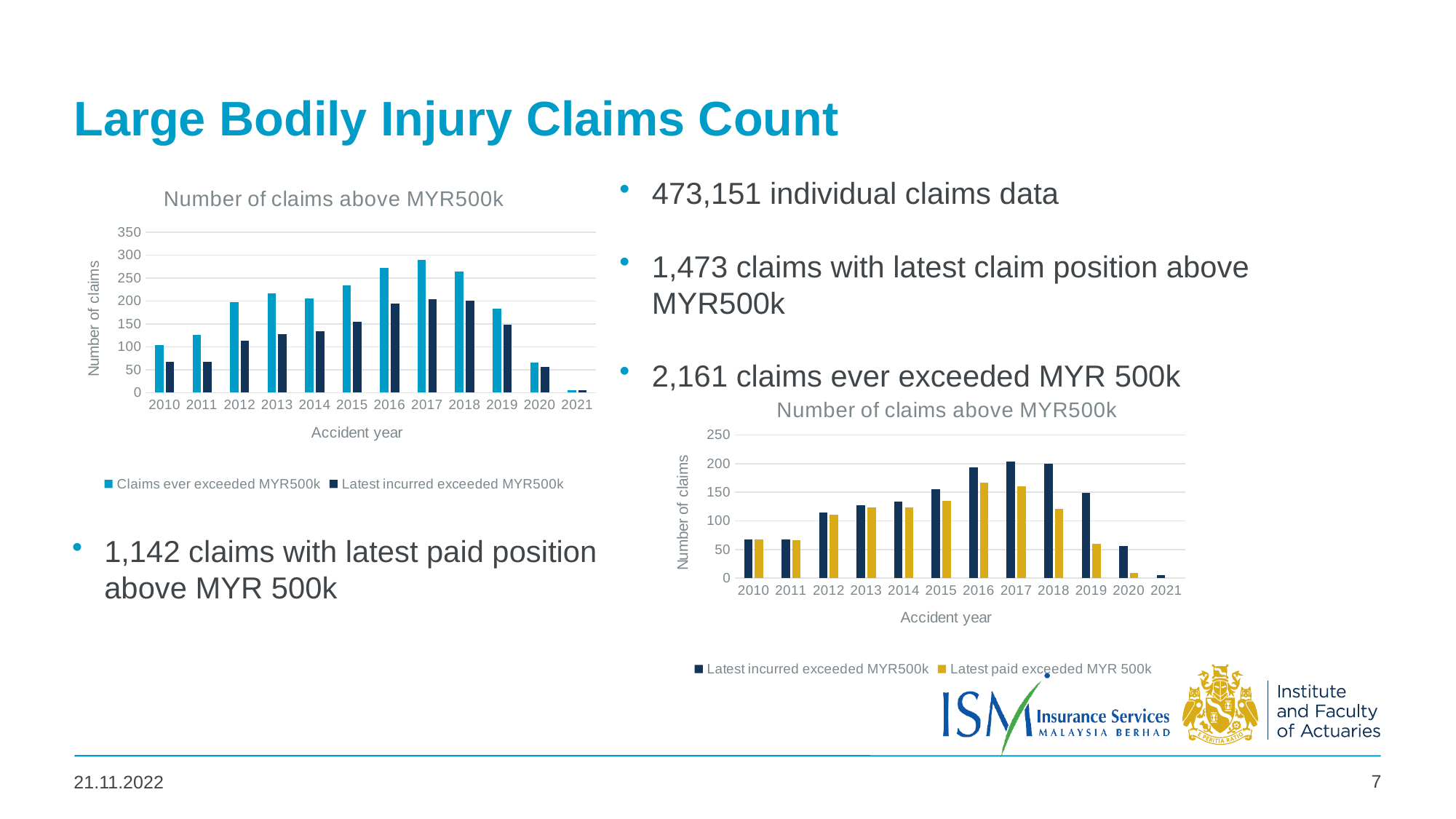
In the left chart, is the value for 'Claims ever exceeded MYR500k' in 2017 greater or less than 250? greater In the left chart, do the values for 'Claims ever exceeded MYR500k' rise or fall from 2010 to 2017? rise In the right chart, is the value for 'Latest paid exceeded MYR 500k' in 2016 greater or less than 150? greater In the left chart, which is larger in 2015: 'Claims ever exceeded MYR500k' or 'Latest incurred exceeded MYR500k'? Claims ever exceeded MYR500k Which series in the right chart is shown in gold? Latest paid exceeded MYR 500k How many accident years are shown on the x axis of the left chart? 12 In the left chart, is the value for 'Latest incurred exceeded MYR500k' in 2010 greater or less than 100? less In the right chart, which is larger in 2019: 'Latest incurred exceeded MYR500k' or 'Latest paid exceeded MYR 500k'? Latest incurred exceeded MYR500k What is the label of the y axis on the right chart? Number of claims In the left chart, which accident year has the highest value for 'Claims ever exceeded MYR500k'? 2017 How many series does the legend of the left chart list? 2 What type of chart is the left chart titled 'Number of claims above MYR500k'? bar chart